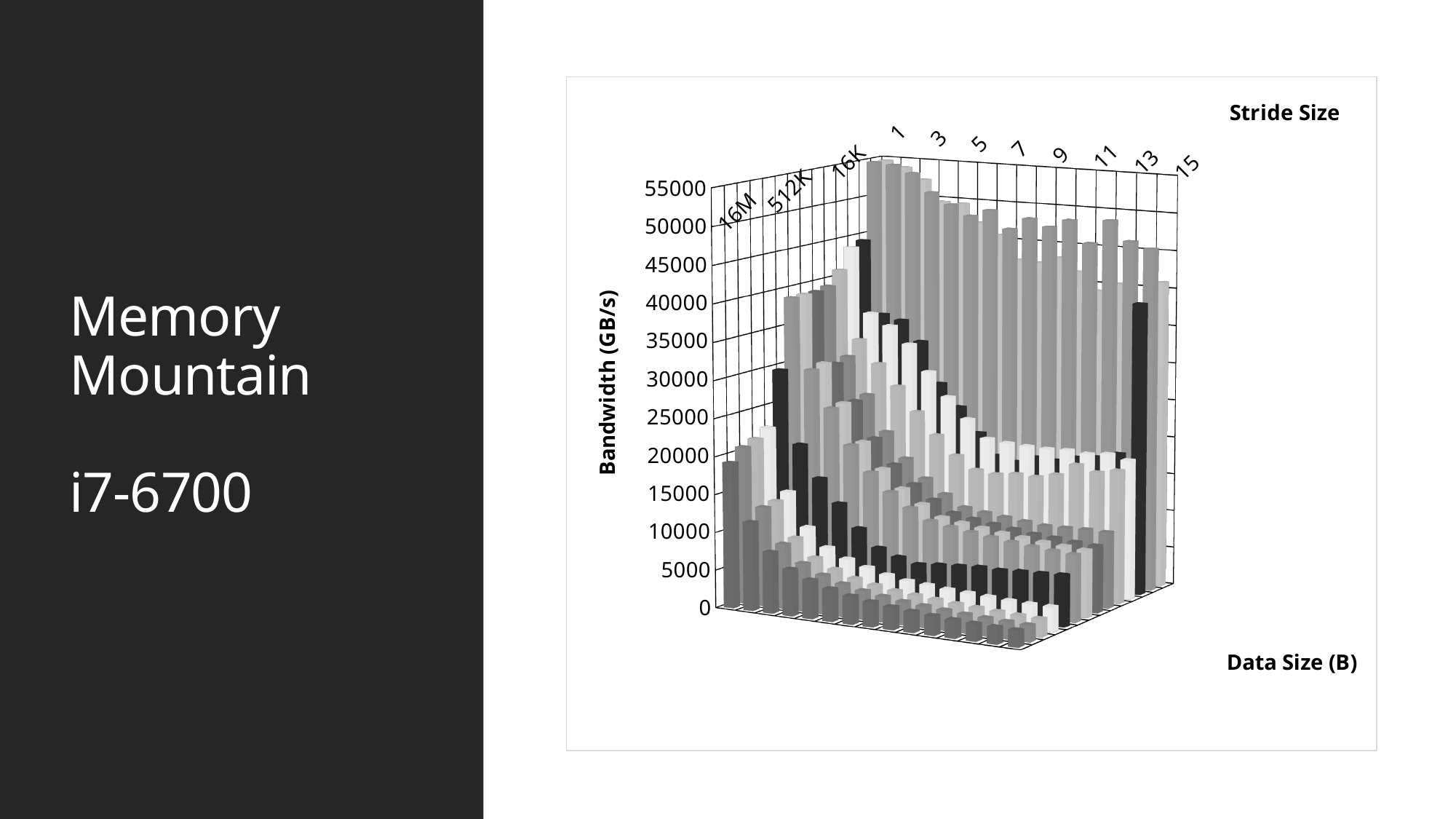
What kind of chart is shown on the slide? bar chart What is the lowest tick value on the bandwidth axis? 0 Which data size labels are readable on the data size axis? 16M, 512K, 16K Is the tallest bar in the chart greater or less than 40000? greater What is the interval between ticks on the bandwidth axis? 5000 What is the label of the vertical axis? Bandwidth (GB/s) Which stride size label is the largest shown on the stride axis? 15 What are the two horizontal axes of the chart labelled? Stride Size and Data Size (B) How many stride size labels are shown along the stride axis? 8 What is the highest tick value on the bandwidth axis? 55000 As stride size increases from 1 to 15, does bandwidth generally rise or fall? fall